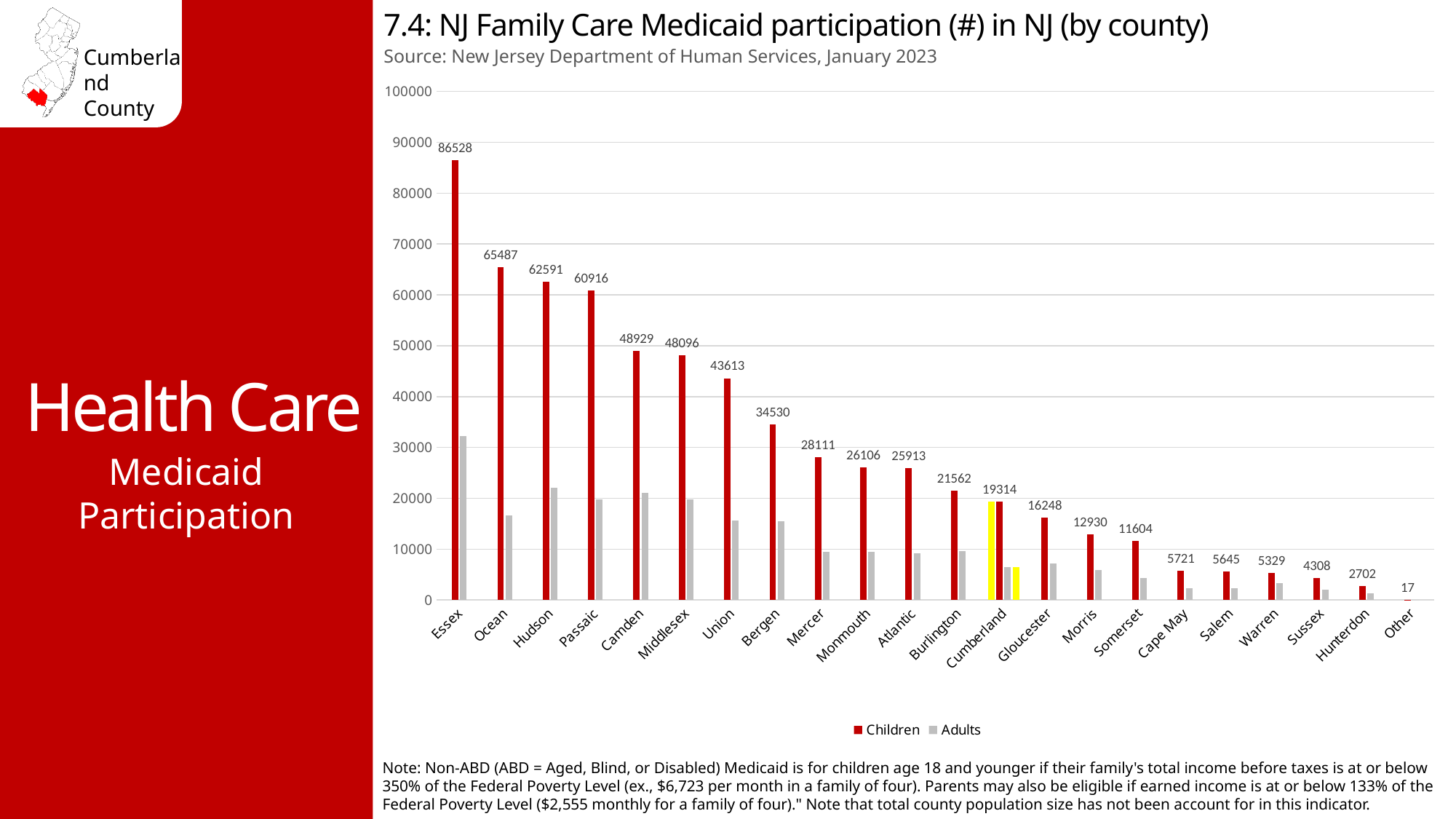
What kind of chart is shown on the slide? bar chart Which category has the lowest Children value? Other Do the Children values rise or fall moving from left to right along the x axis? fall How many categories are shown on the x axis? 22 How many series does the legend list? 2 Is the Adults value for Essex greater or less than 30000? greater What is the number of children participating in NJ Family Care Medicaid in Essex county? 86528 What is the difference between the Children values for Essex and Ocean? 21041 What is the Children value for Cumberland county? 19314 What is the Children value for Hunterdon county? 2702 Which has a larger Children value, Camden or Middlesex? Camden Which category has the highest Children value? Essex